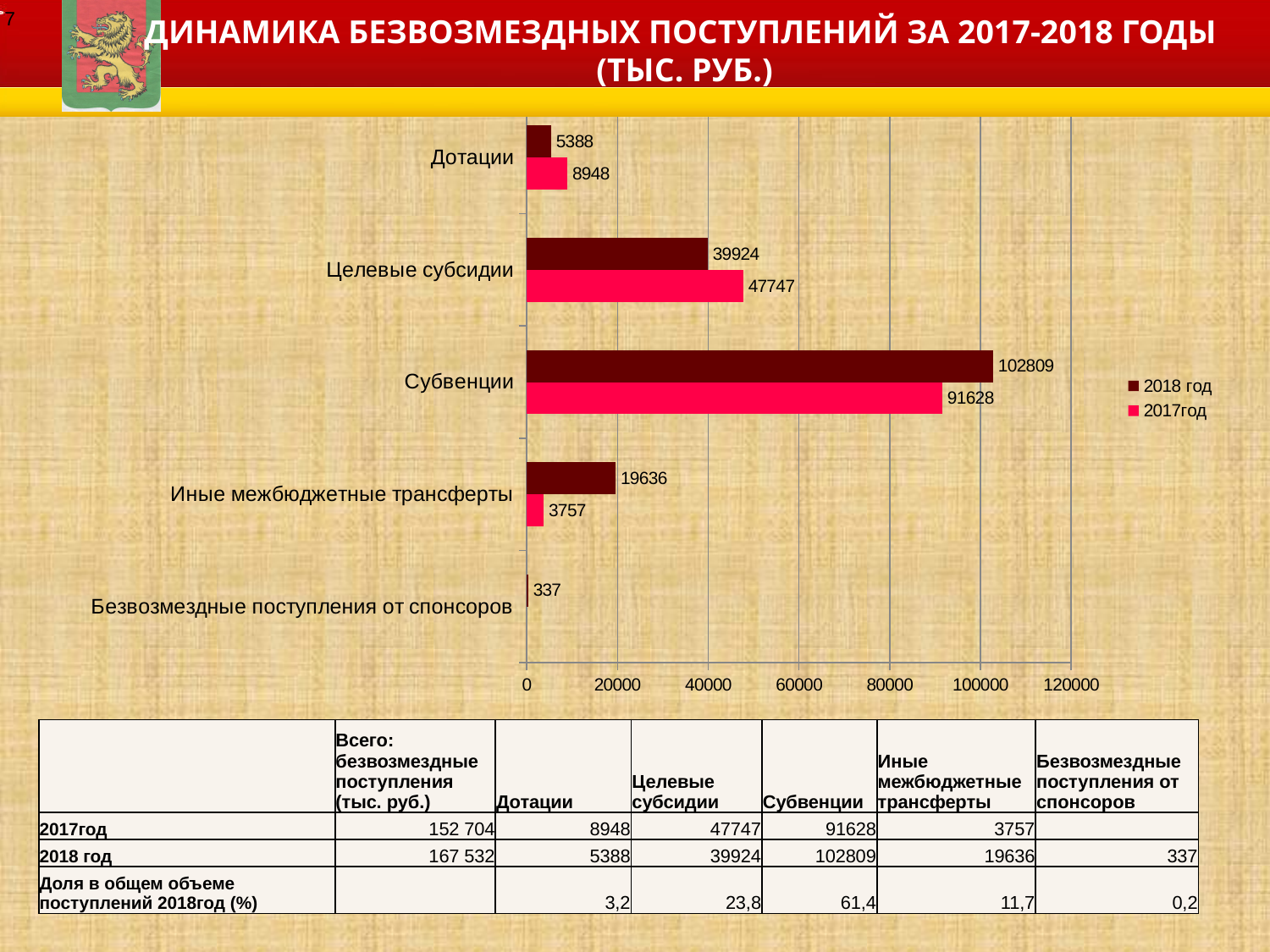
How many categories are shown on the chart? 5 Is the 2017год value for Субвенции greater or less than 80000? greater What is the value for Субвенции in the 2018 год series? 102809 What is the value for Иные межбюджетные трансферты in the 2018 год series? 19636 Which category has the highest value in the 2018 год series? Субвенции How many series does the legend list? 2 What is the value for Дотации in the 2017год series? 8948 What is the difference between the 2018 год and 2017год values for Субвенции? 11181 What kind of chart is shown on the slide? bar chart Which is larger for Целевые субсидии: the 2018 год value or the 2017год value? 2017год What is the value for Целевые субсидии in the 2017год series? 47747 Which category has the lowest value in the 2018 год series? Безвозмездные поступления от спонсоров